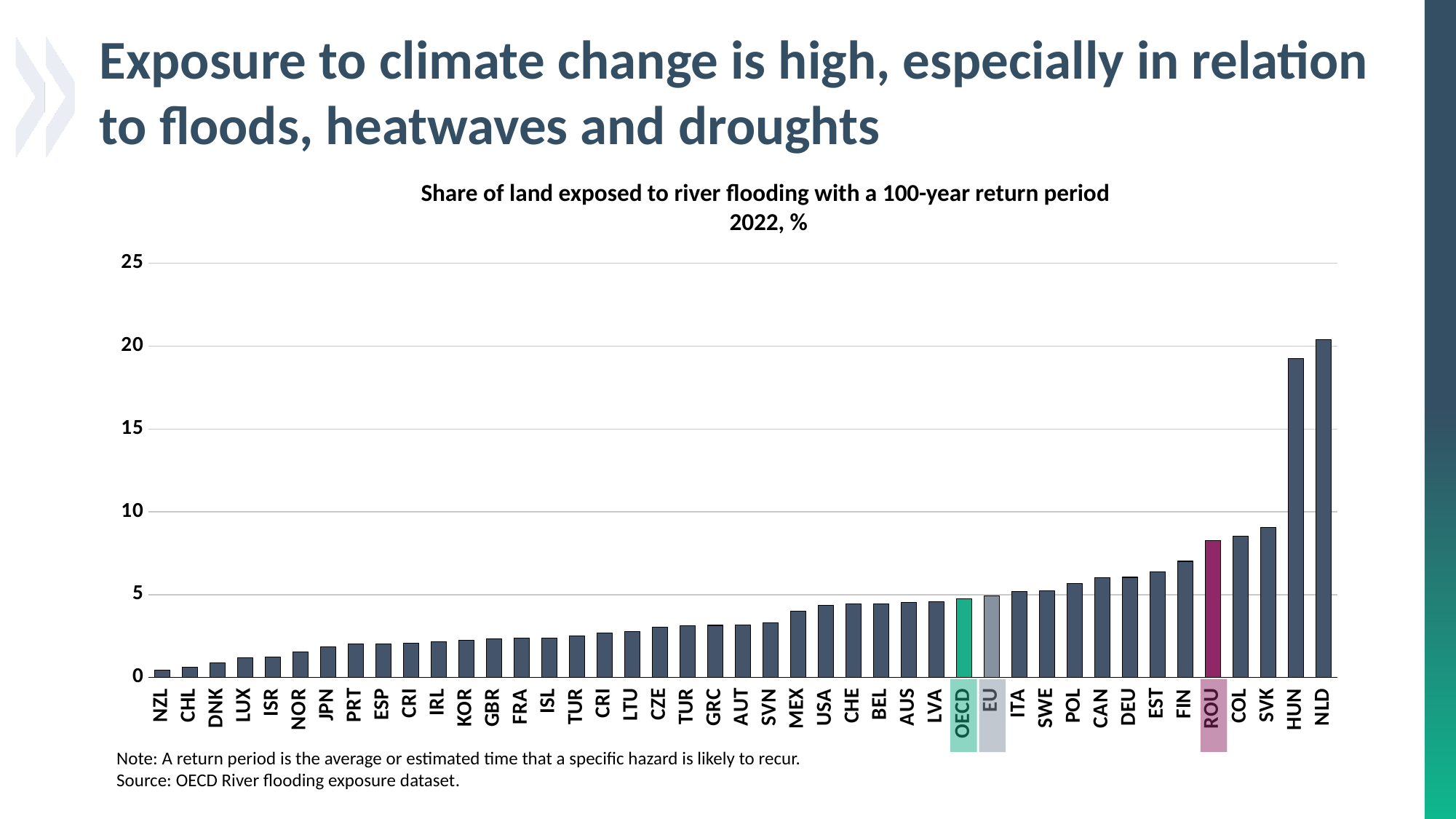
Which country has the lowest share of land exposed to river flooding? NZL Do the bar values rise or fall from left to right along the x axis? rise Is the value for HUN greater or less than 20? less How many bars are plotted in the chart? 43 Is the value for SVK greater or less than 10? less Which country has the highest share of land exposed to river flooding? NLD What is the title of the chart? Share of land exposed to river flooding with a 100-year return period 2022, % Is the value for NZL greater or less than 5? less What kind of chart is shown on the slide? bar chart Which has a larger value, ROU or OECD? ROU Which has a larger value, HUN or SVK? HUN